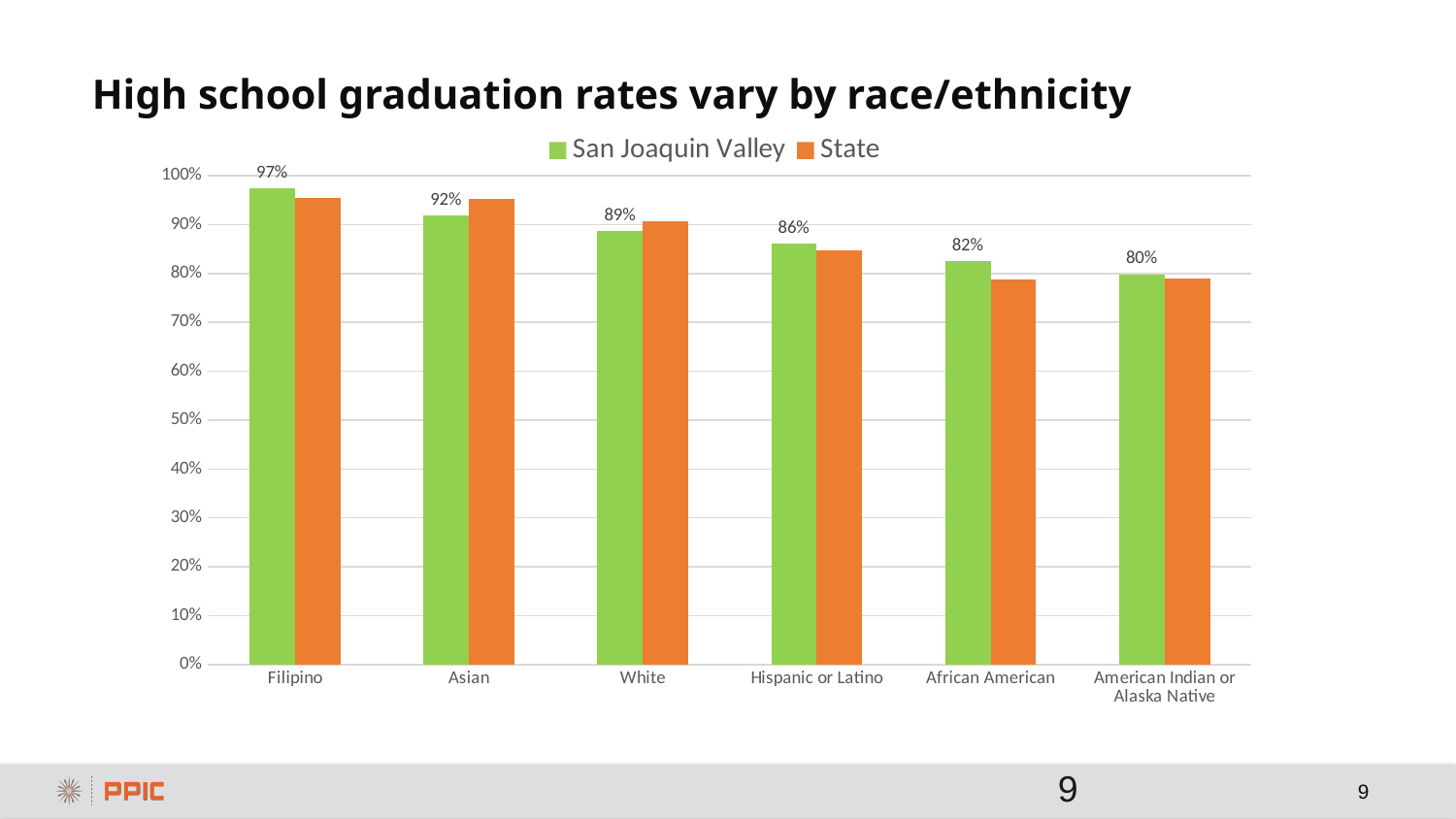
For Asian students, which is higher: the San Joaquin Valley rate or the State rate? State How many race/ethnicity categories are shown on the x axis? 6 What is the San Joaquin Valley graduation rate for American Indian or Alaska Native students? 80% How many series does the legend list? 2 For African American students, which is higher: the San Joaquin Valley rate or the State rate? San Joaquin Valley What is the difference between the San Joaquin Valley graduation rates for Filipino and African American students? 15% Do the San Joaquin Valley graduation rates rise or fall moving from left to right across the categories? fall Is the State graduation rate for African American students greater or less than 80%? less What is the San Joaquin Valley high school graduation rate for Filipino students? 97% Which race/ethnicity group has the highest San Joaquin Valley graduation rate? Filipino Which race/ethnicity group has the lowest San Joaquin Valley graduation rate? American Indian or Alaska Native What is the San Joaquin Valley graduation rate for Hispanic or Latino students? 86%